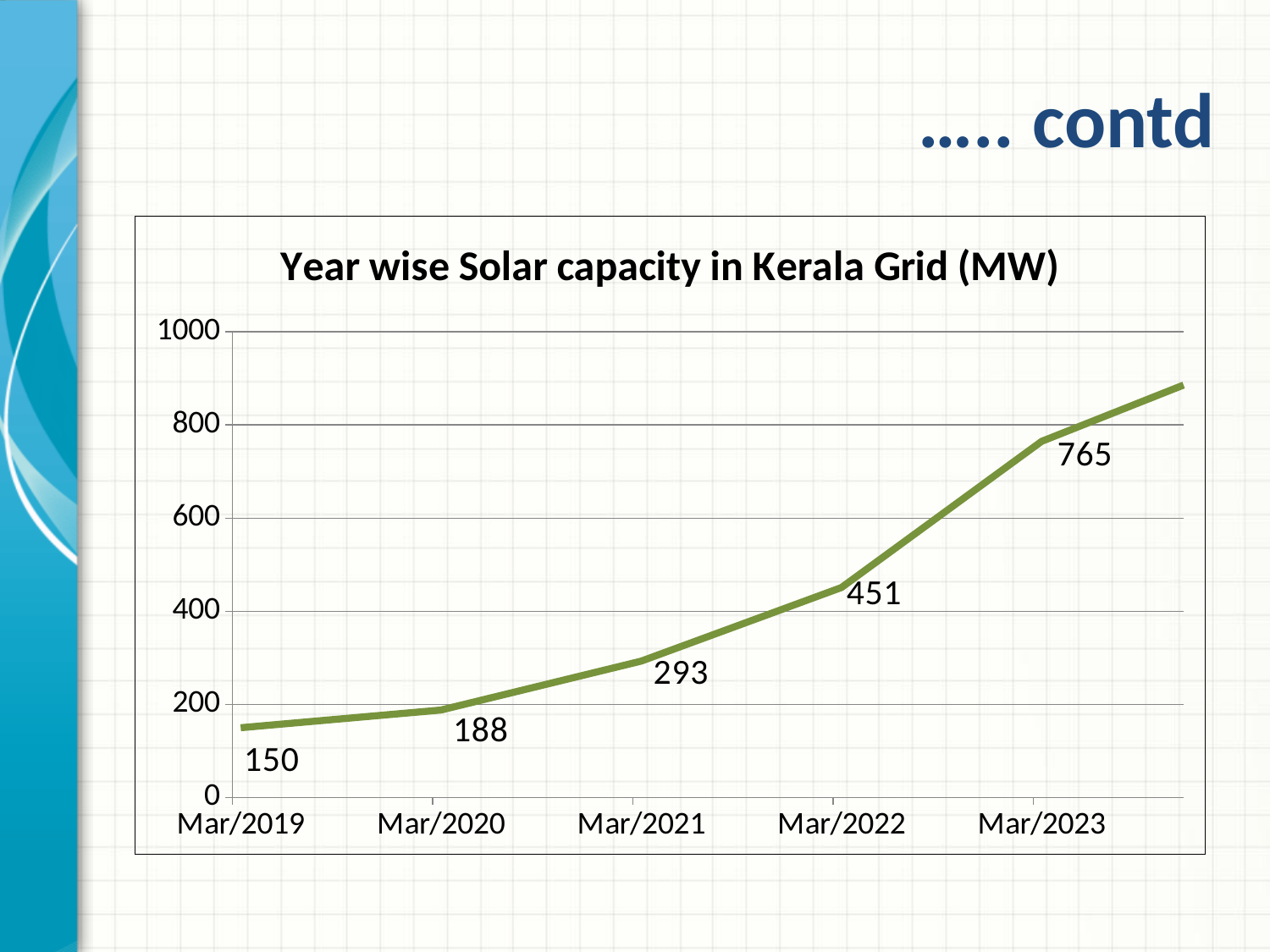
Do the values rise or fall from Mar/2019 to Mar/2023? rise What is the difference between the values for Mar/2023 and Mar/2022? 314 Which of the labeled years has the highest solar capacity value? Mar/2023 Which year has the lowest solar capacity value? Mar/2019 What is the title of the chart? Year wise Solar capacity in Kerala Grid (MW) What type of chart is shown on the slide? line chart What is the solar capacity value for Mar/2022? 451 What is the difference between the values for Mar/2021 and Mar/2020? 105 What is the solar capacity value for Mar/2021? 293 What is the solar capacity value for Mar/2019? 150 Which is larger, the value for Mar/2020 or the value for Mar/2021? Mar/2021 What is the solar capacity value for Mar/2023? 765